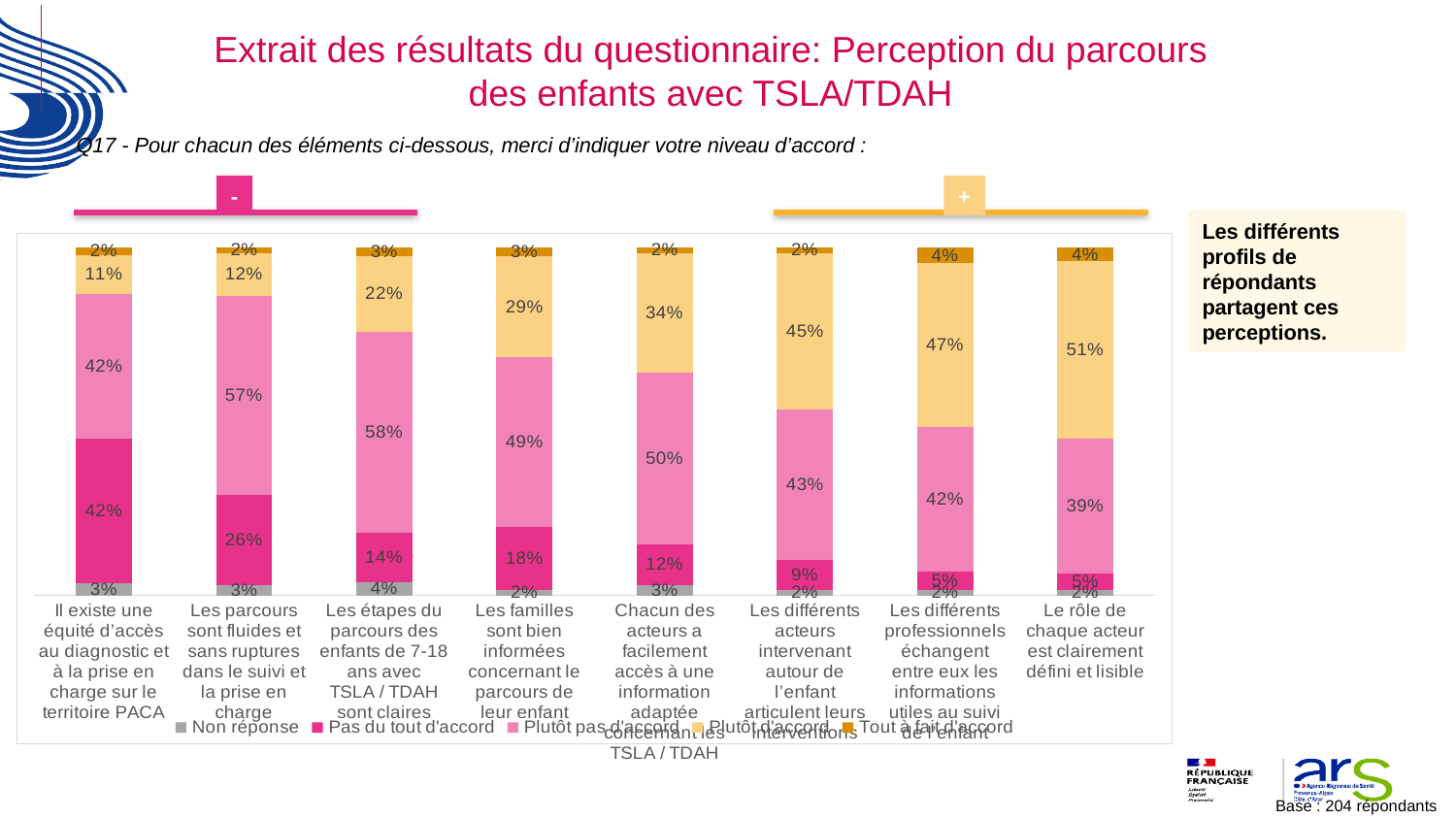
What is the combined share of 'Plutôt d'accord' and 'Tout à fait d'accord' for 'Les différents professionnels échangent entre eux les informations utiles au suivi de l'enfant'? 51% How many series does the legend list? 5 Which legend entry is shown in grey? Non réponse What kind of chart is shown on the slide? Stacked bar chart How many categories (statements) are shown on the x axis? 8 What is the difference between the 'Plutôt pas d'accord' values for 'Les parcours sont fluides et sans ruptures dans le suivi et la prise en charge' (57%) and 'Les familles sont bien informées concernant le parcours de leur enfant' (49%)? 8% Which statement has the highest 'Plutôt d'accord' share? Le rôle de chaque acteur est clairement défini et lisible What is the 'Pas du tout d'accord' value for 'Il existe une équité d'accès au diagnostic et à la prise en charge sur le territoire PACA'? 42% What is the 'Plutôt pas d'accord' value for 'Les étapes du parcours des enfants de 7-18 ans avec TSLA / TDAH sont claires'? 58% Which is larger: the 'Plutôt d'accord' value for 'Chacun des acteurs a facilement accès à une information adaptée concernant les TSLA / TDAH' or for 'Les différents acteurs intervenant autour de l'enfant articulent leurs interventions'? Les différents acteurs intervenant autour de l'enfant articulent leurs interventions What is the 'Plutôt d'accord' value for 'Le rôle de chaque acteur est clairement défini et lisible'? 51% Which statement has the highest 'Pas du tout d'accord' share? Il existe une équité d'accès au diagnostic et à la prise en charge sur le territoire PACA